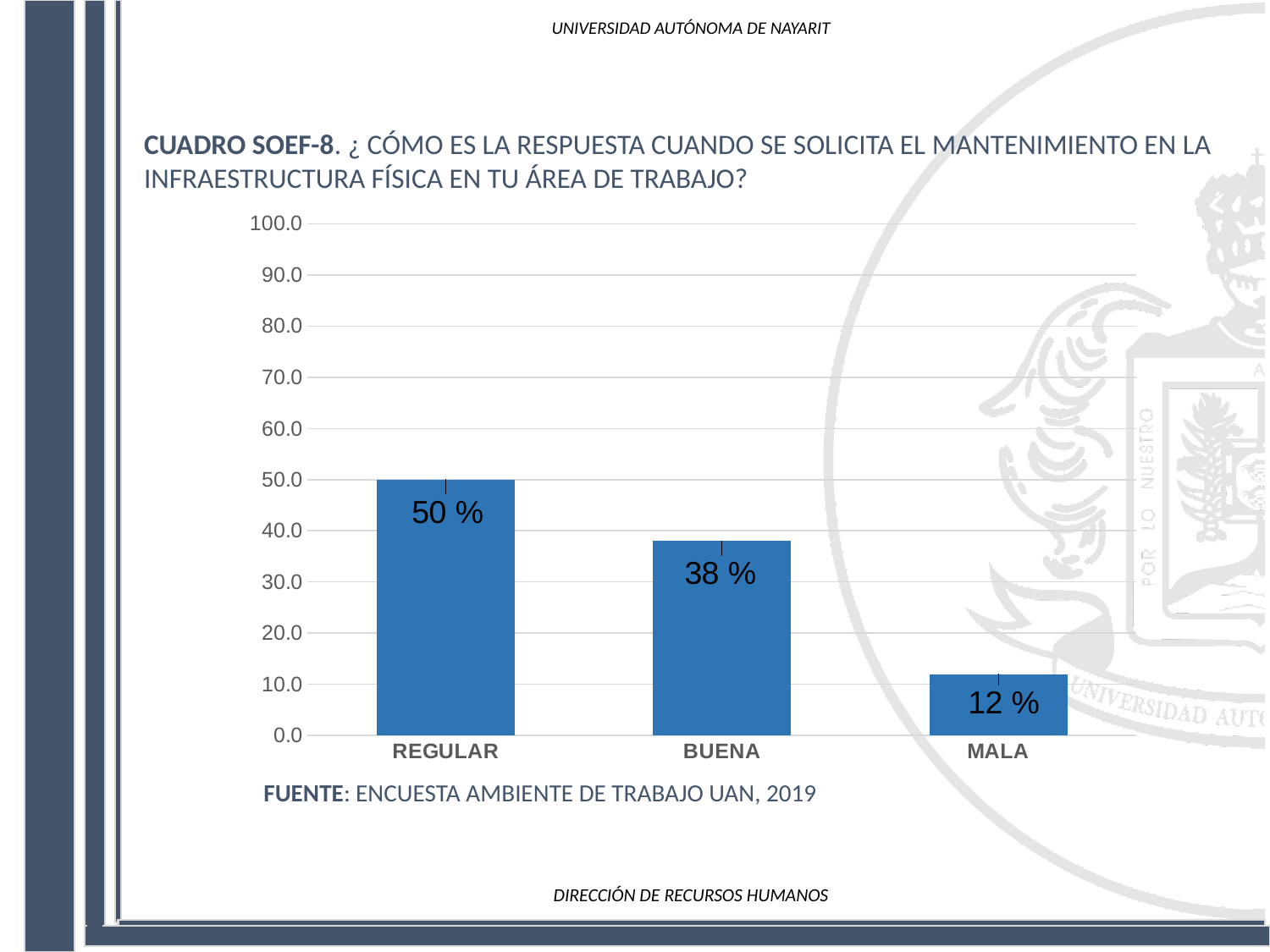
Is the value for BUENA greater or less than 40.0? less Which is larger, the value for BUENA or the value for MALA? BUENA What is the value for MALA? 12 % What is the value for REGULAR? 50 % What kind of chart is shown on the slide? bar chart What is the difference between the values for REGULAR and BUENA? 12 % Which category has the highest value? REGULAR How many categories are shown on the x axis? 3 What is the value for BUENA? 38 % What source is cited below the chart? ENCUESTA AMBIENTE DE TRABAJO UAN, 2019 What is the difference between the values for BUENA and MALA? 26 % Which category has the lowest value? MALA